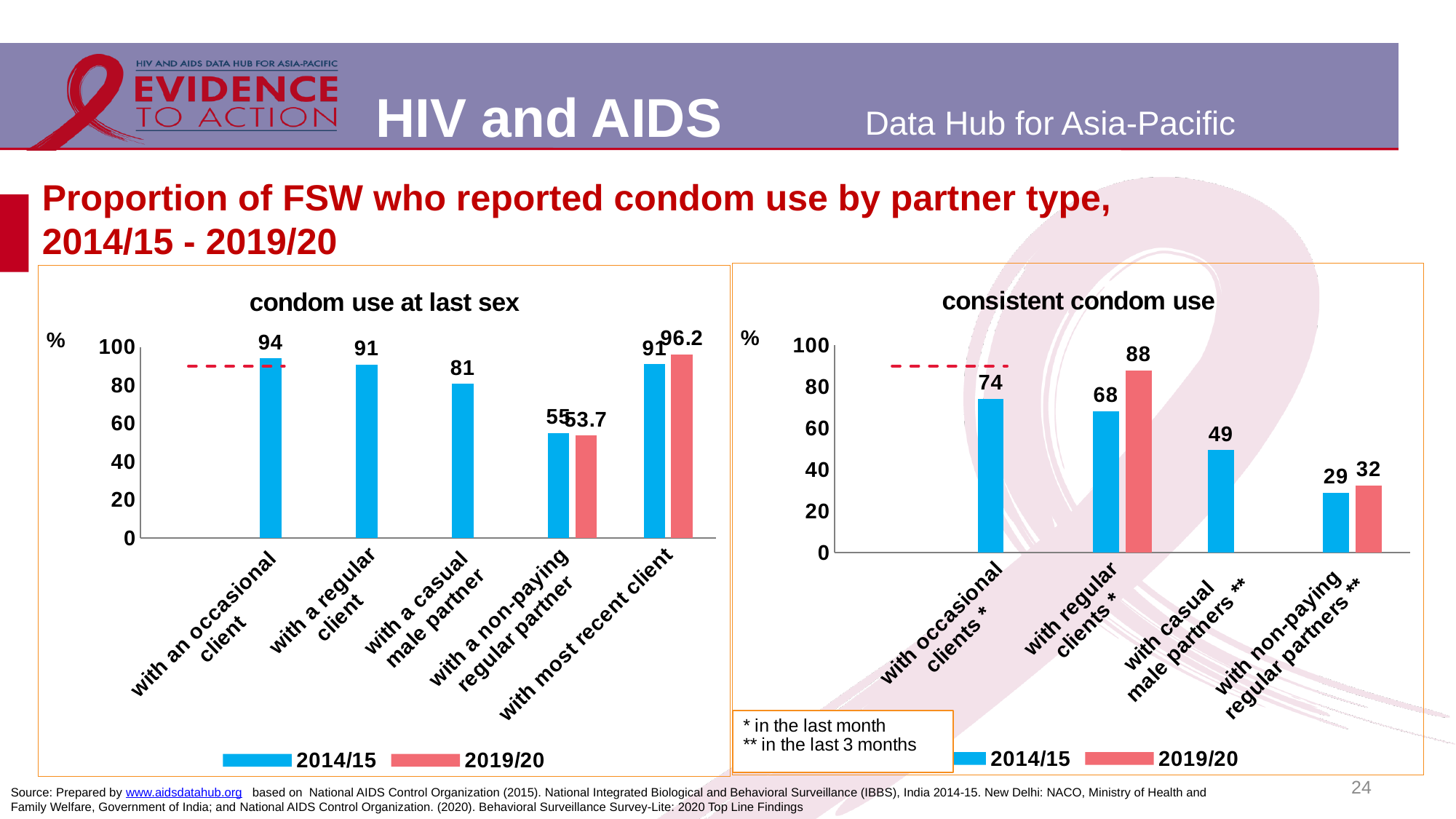
In the 'consistent condom use' chart, which category has the lowest 2014/15 value? with non-paying regular partners In the 'condom use at last sex' chart, what is the 2019/20 value for 'with a non-paying regular partner'? 53.7 In the 'condom use at last sex' chart, which category has the lowest 2014/15 value? with a non-paying regular partner In the 'consistent condom use' chart, which is larger: the 2014/15 value for 'with occasional clients' or the 2014/15 value for 'with regular clients'? with occasional clients In the 'consistent condom use' chart, what is the difference between the 2019/20 and 2014/15 values for 'with regular clients'? 20 What type of chart is the 'condom use at last sex' chart? bar chart How many series does the legend of the 'consistent condom use' chart list? 2 In the 'condom use at last sex' chart, what is the 2019/20 value for 'with most recent client'? 96.2 In the 'consistent condom use' chart, what is the 2014/15 value for 'with casual male partners'? 49 In the 'condom use at last sex' chart, what is the 2014/15 value for 'with an occasional client'? 94 In the 'consistent condom use' chart, what is the 2019/20 value for 'with regular clients'? 88 In the 'condom use at last sex' chart, what is the difference between the 2019/20 and 2014/15 values for 'with most recent client'? 5.2